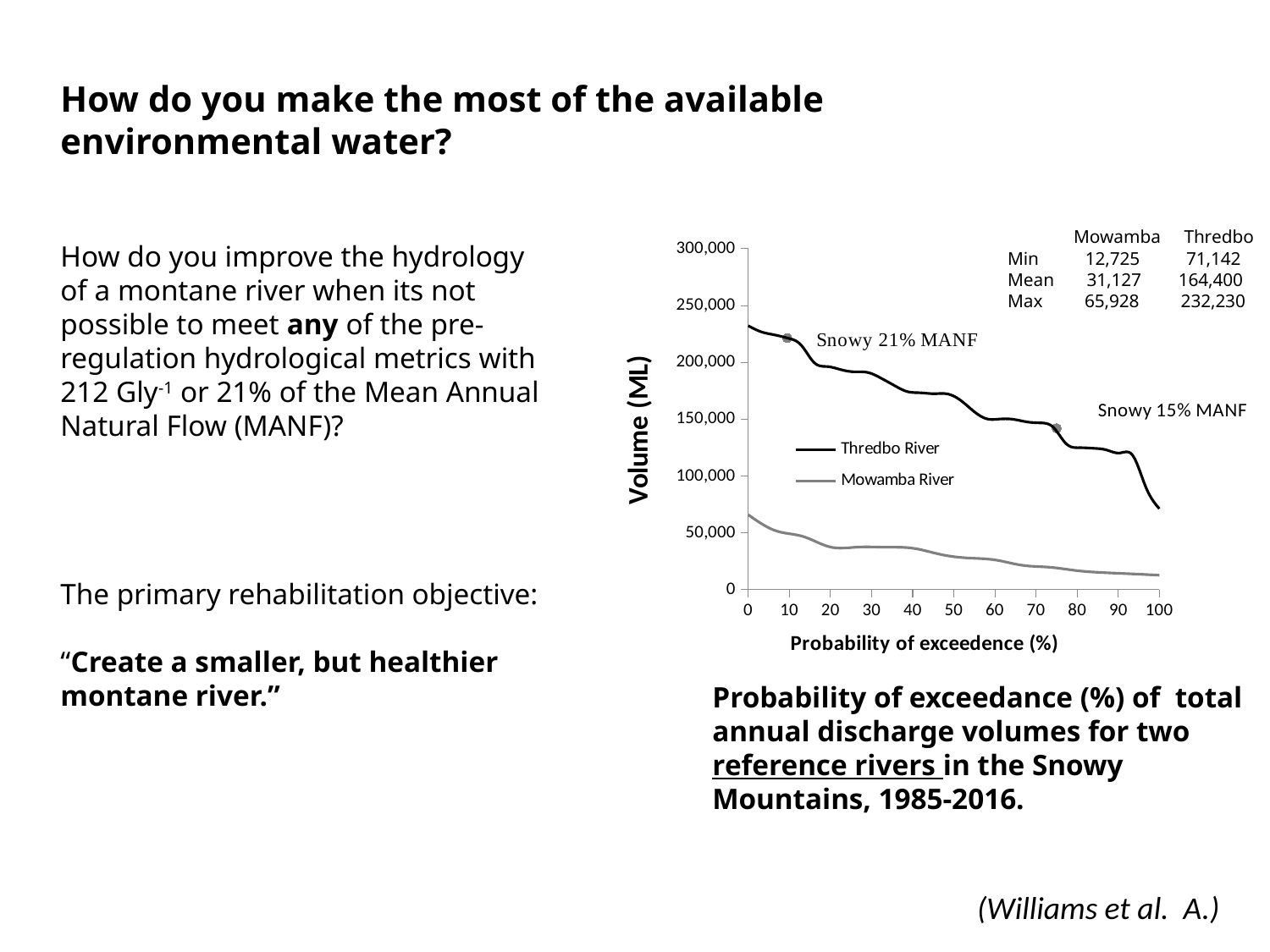
Which two rivers are plotted in the chart? Thredbo River and Mowamba River Is the Mowamba River volume at 100% probability of exceedence greater or less than 50,000 ML? less Is the Mowamba River volume at 0% probability of exceedence greater or less than 50,000 ML? greater Do the Thredbo River volumes rise or fall as probability of exceedence increases? fall What is the title of the chart's x axis? Probability of exceedence (%) Is the Thredbo River volume at 100% probability of exceedence greater or less than 100,000 ML? less According to the statistics printed on the chart, what is the mean volume for the Thredbo River? 164,400 How many series does the chart legend list? 2 Which river has the higher volume across the chart, Thredbo River or Mowamba River? Thredbo River What kind of chart is shown on the slide? line chart According to the statistics printed on the chart, what is the maximum volume for the Mowamba River? 65,928